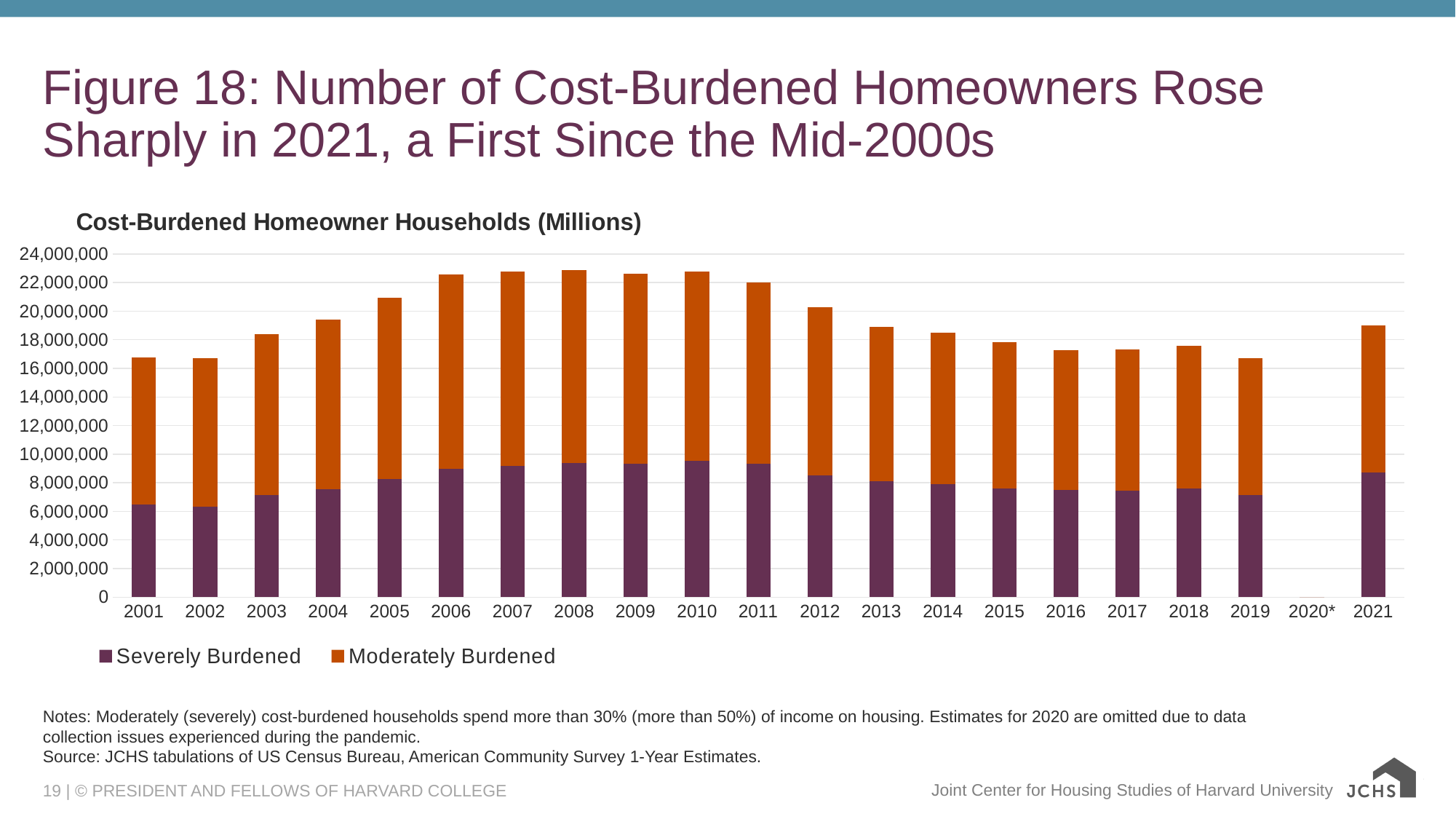
Is the Severely Burdened value for 2010 greater or less than 8,000,000? greater Is the total value for 2021 greater or less than 18,000,000? greater Do the total values rise or fall from 2010 to 2019? fall What kind of chart is shown on the slide? Stacked bar chart Which year has the larger total of cost-burdened homeowner households, 2001 or 2008? 2008 Is the total value for 2006 greater or less than 22,000,000? greater How many year labels are shown on the x axis? 21 Which year has the larger total of cost-burdened homeowner households, 2019 or 2021? 2021 How many series does the legend list? 2 Which series is shown in purple at the bottom of each stacked bar? Severely Burdened